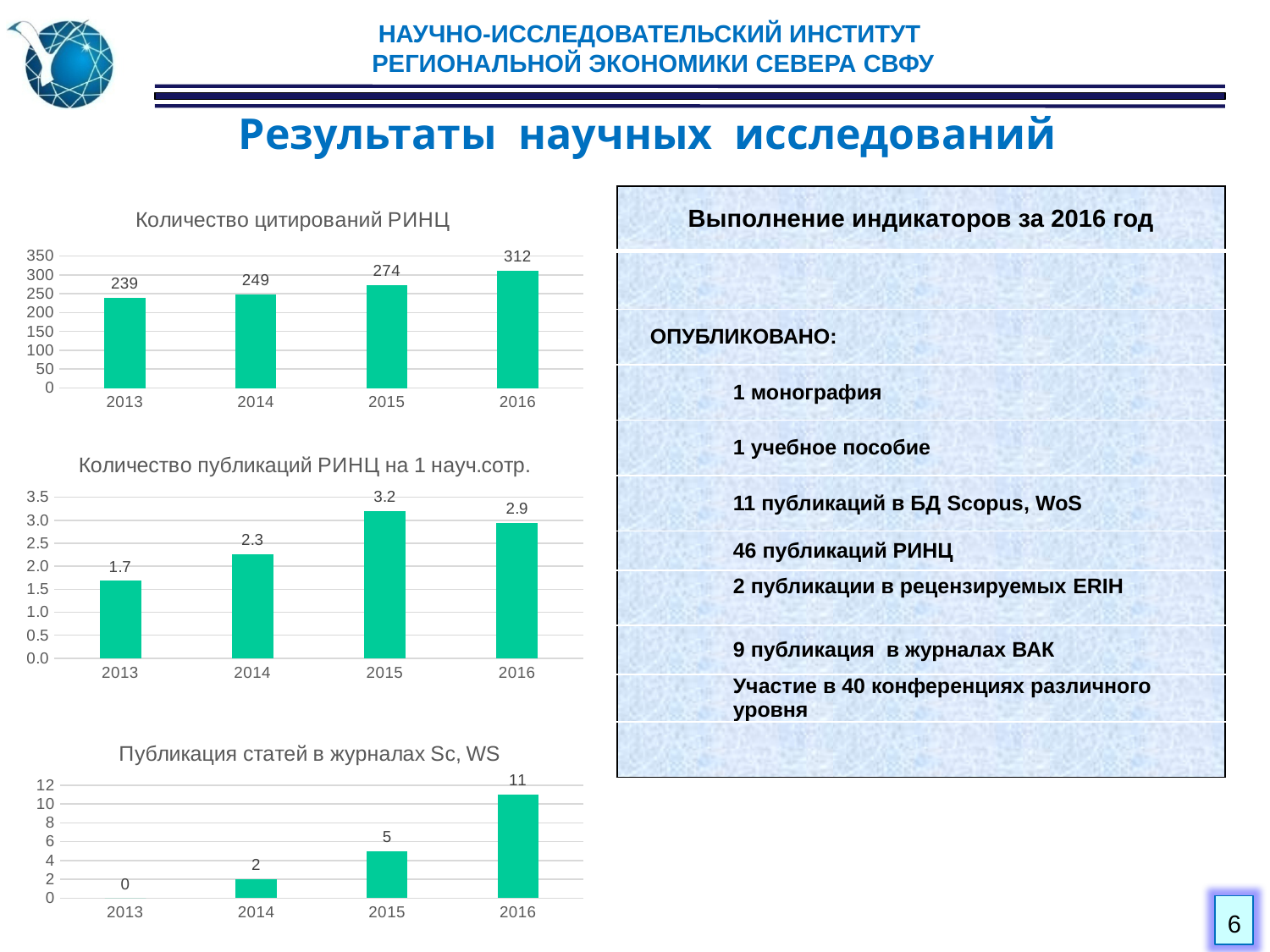
In the chart 'Количество публикаций РИНЦ на 1 науч.сотр.', how many years are shown on the x axis? 4 What kind of chart is 'Публикация статей в журналах Sc, WS'? bar chart In the chart 'Количество публикаций РИНЦ на 1 науч.сотр.', which year has the highest value? 2015 In the chart 'Количество цитирований РИНЦ', what is the value for 2016? 312 In the chart 'Публикация статей в журналах Sc, WS', what is the value for 2014? 2 In the chart 'Количество цитирований РИНЦ', do the values rise or fall from 2013 to 2016? rise In the chart 'Публикация статей в журналах Sc, WS', what is the difference between the values for 2016 and 2015? 6 In the chart 'Количество цитирований РИНЦ', what is the difference between the values for 2016 and 2013? 73 In the chart 'Количество публикаций РИНЦ на 1 науч.сотр.', which is larger, the value for 2014 or the value for 2016? 2016 In the chart 'Количество публикаций РИНЦ на 1 науч.сотр.', what is the value for 2015? 3.2 What is the title of the top chart on the slide? Количество цитирований РИНЦ In the chart 'Количество цитирований РИНЦ', which year has the lowest value? 2013